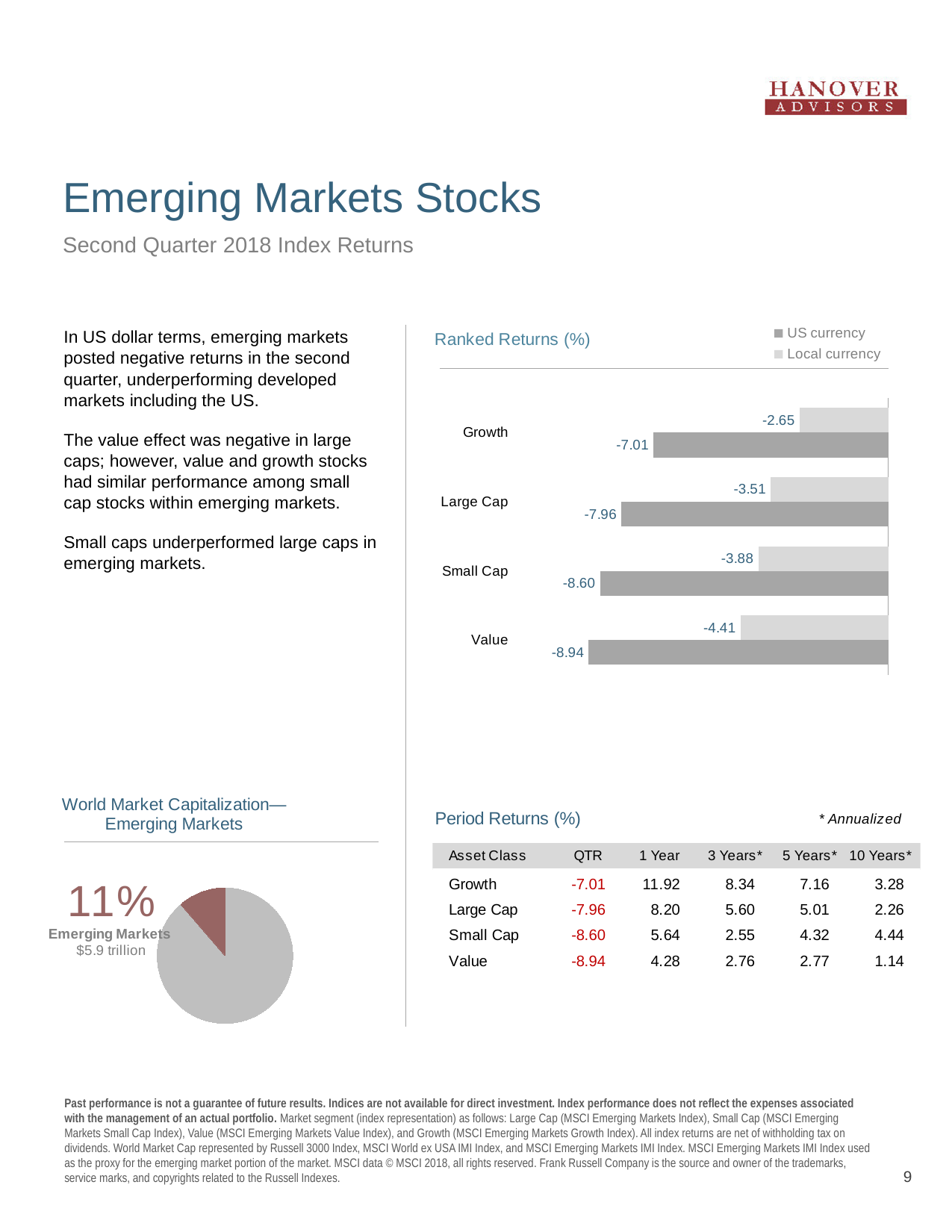
How many series does the legend of the Ranked Returns (%) chart list? 2 What are the two legend entries in the Ranked Returns (%) chart? US currency and Local currency In the Ranked Returns (%) chart, what is the US currency return for Growth? -7.01 In the Ranked Returns (%) chart, what is the difference between the US currency and Local currency returns for Large Cap? 4.45 In the Ranked Returns (%) chart, which category has the lowest US currency return? Value In the World Market Capitalization—Emerging Markets pie chart, what share of the pie is Emerging Markets? 11% In the Ranked Returns (%) chart, which is larger, the US currency return for Small Cap or the US currency return for Large Cap? Large Cap In the Ranked Returns (%) chart, which category has the highest Local currency return? Growth In the Ranked Returns (%) chart, what is the Local currency return for Value? -4.41 What kind of chart is the Ranked Returns (%) chart? Bar chart How many categories are shown in the Ranked Returns (%) chart? 4 In the Ranked Returns (%) chart, what is the Local currency return for Small Cap? -3.88